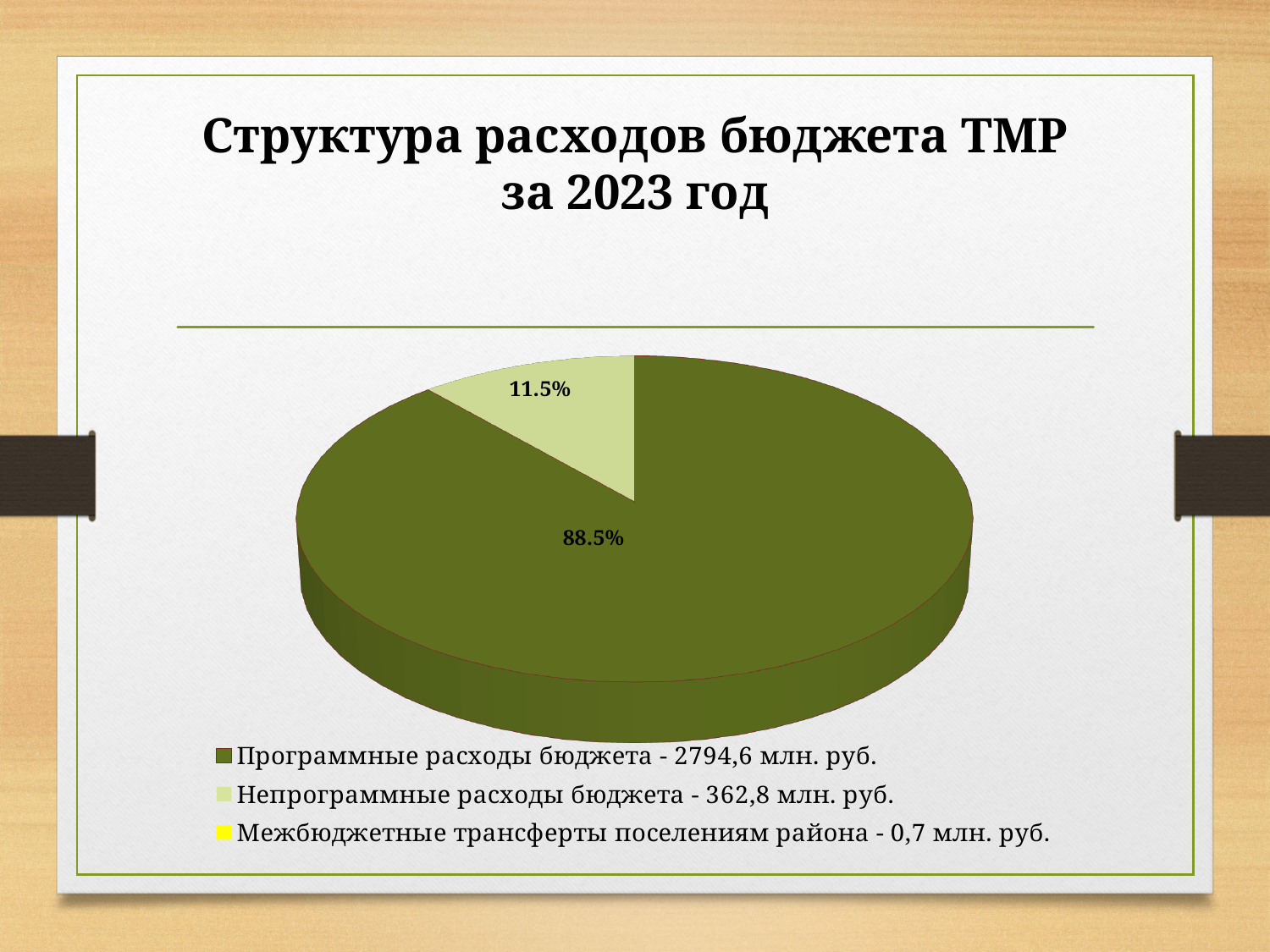
How many entries does the legend list? 3 What is the difference in percentage points between the 88.5% slice and the 11.5% slice? 77.0 percentage points Which category has the largest slice of the pie? Программные расходы бюджета According to the legend, what is the amount for Межбюджетные трансферты поселениям района? 0,7 млн. руб. What share of the pie is labelled for Непрограммные расходы бюджета? 11.5% What kind of chart is shown on the slide? pie chart What is the title of the chart? Структура расходов бюджета ТМР за 2023 год What colour is the slice for Непрограммные расходы бюджета? light green What share of the pie is labelled for Программные расходы бюджета? 88.5% According to the legend, what is the amount for Программные расходы бюджета? 2794,6 млн. руб. According to the legend, what is the amount for Непрограммные расходы бюджета? 362,8 млн. руб. Which is larger: the share for Программные расходы бюджета or for Непрограммные расходы бюджета? Программные расходы бюджета